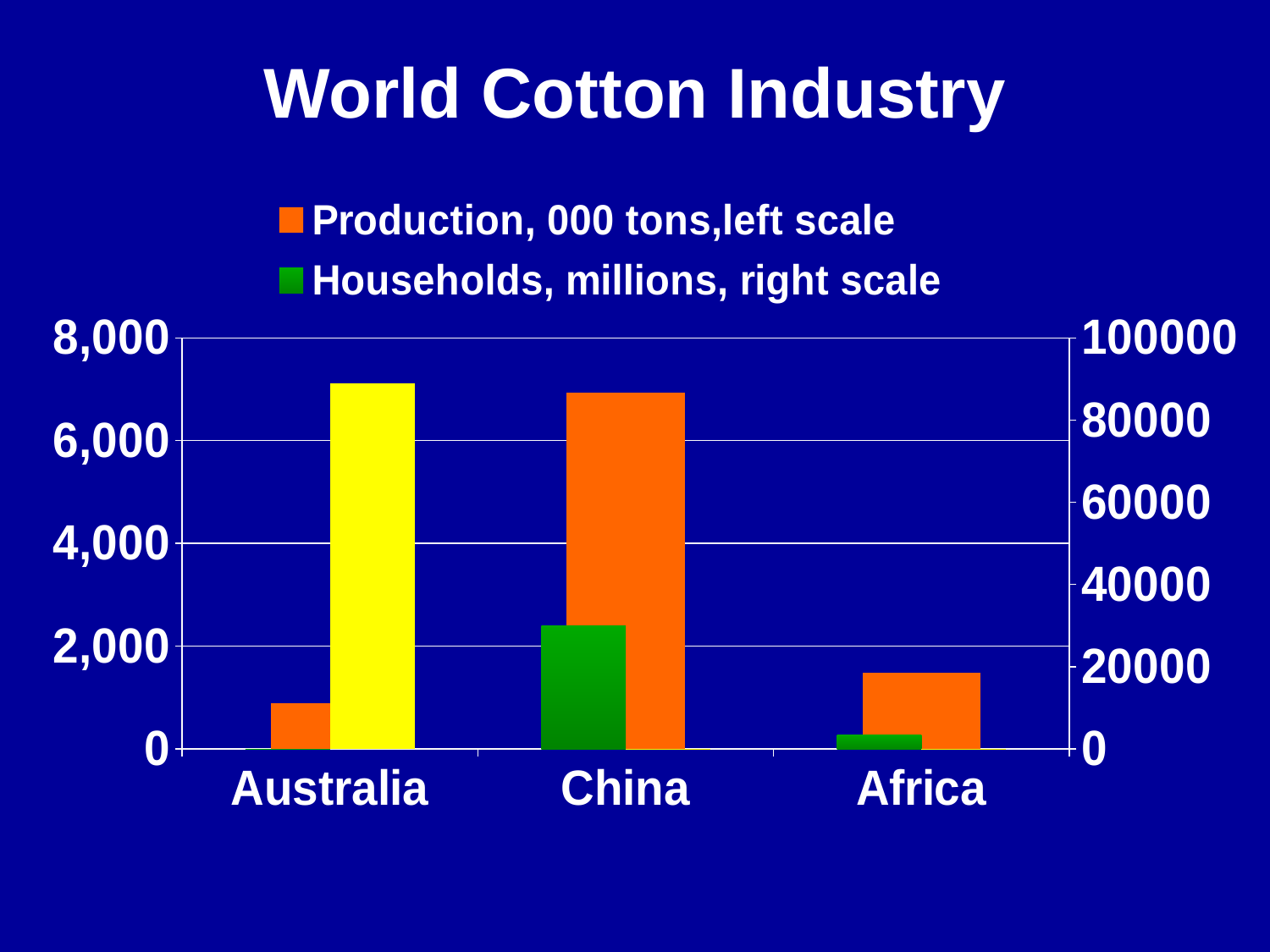
Is the Households value for China greater or less than 20000 on the right scale? greater How many series does the legend list? 2 Is the Households value for Africa greater or less than 20000 on the right scale? less Which category has the highest Production, 000 tons? China Is the Production value for China greater or less than 6,000? greater According to the legend, which scale is used for the Households, millions series? right scale Which has the larger Production value, Africa or Australia? Africa Which category has the lowest Production, 000 tons? Australia What kind of chart is shown on the slide? bar chart How many categories are shown on the x axis of the chart? 3